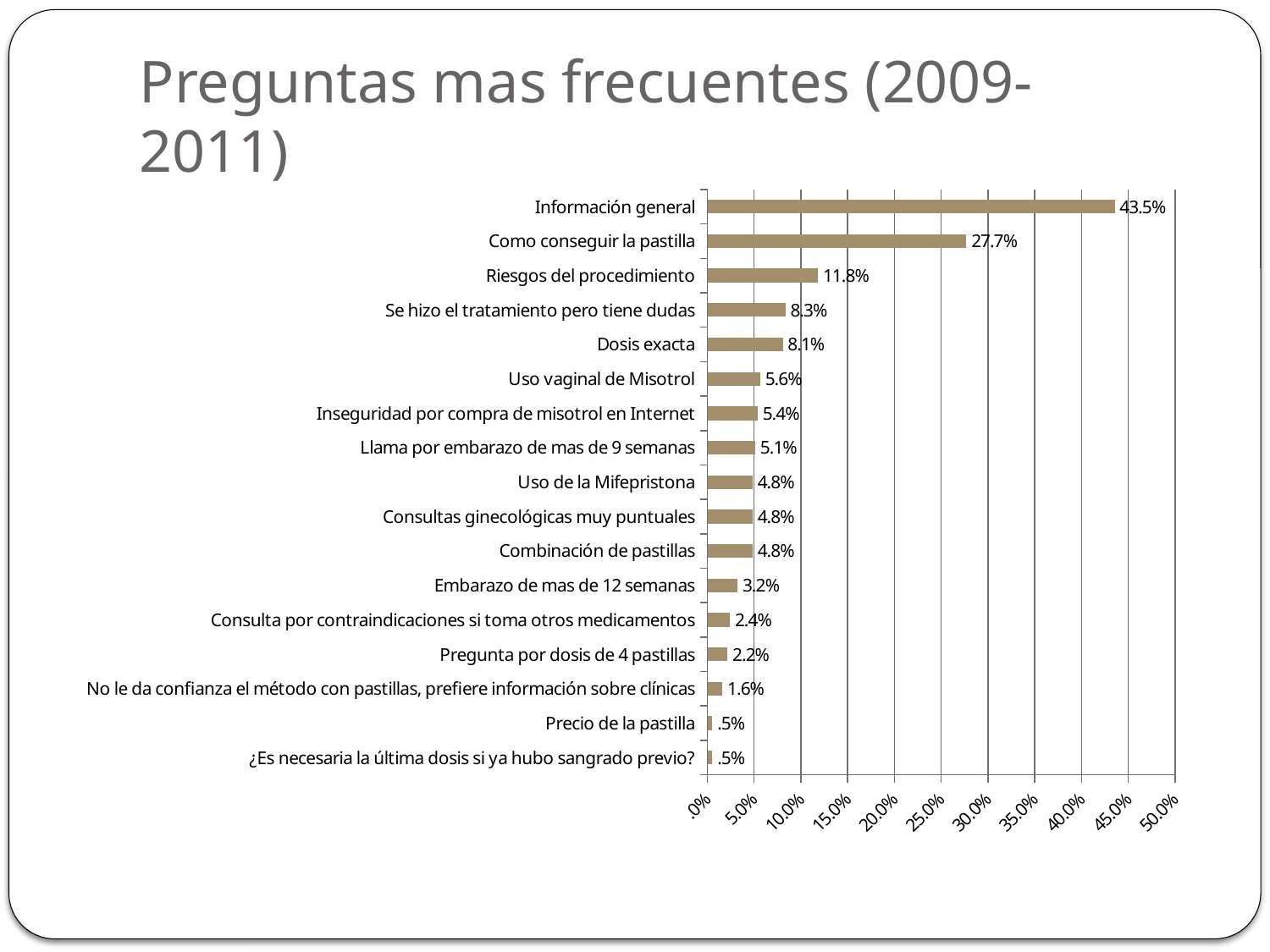
What is the value for Como conseguir la pastilla? 27.7% What kind of chart is shown on the slide? Bar chart Which category has the highest value? Información general What is the value for Uso vaginal de Misotrol? 5.6% Is the value for Como conseguir la pastilla greater or less than 25.0%? greater What is the value for Información general? 43.5% What is the difference between Riesgos del procedimiento and Se hizo el tratamiento pero tiene dudas? 3.5 percentage points How many categories are shown in the chart? 17 What is the difference between Información general and Como conseguir la pastilla? 15.8 percentage points What is the value for Riesgos del procedimiento? 11.8% What is the value for Precio de la pastilla? .5% Which is larger, Dosis exacta or Embarazo de mas de 12 semanas? Dosis exacta